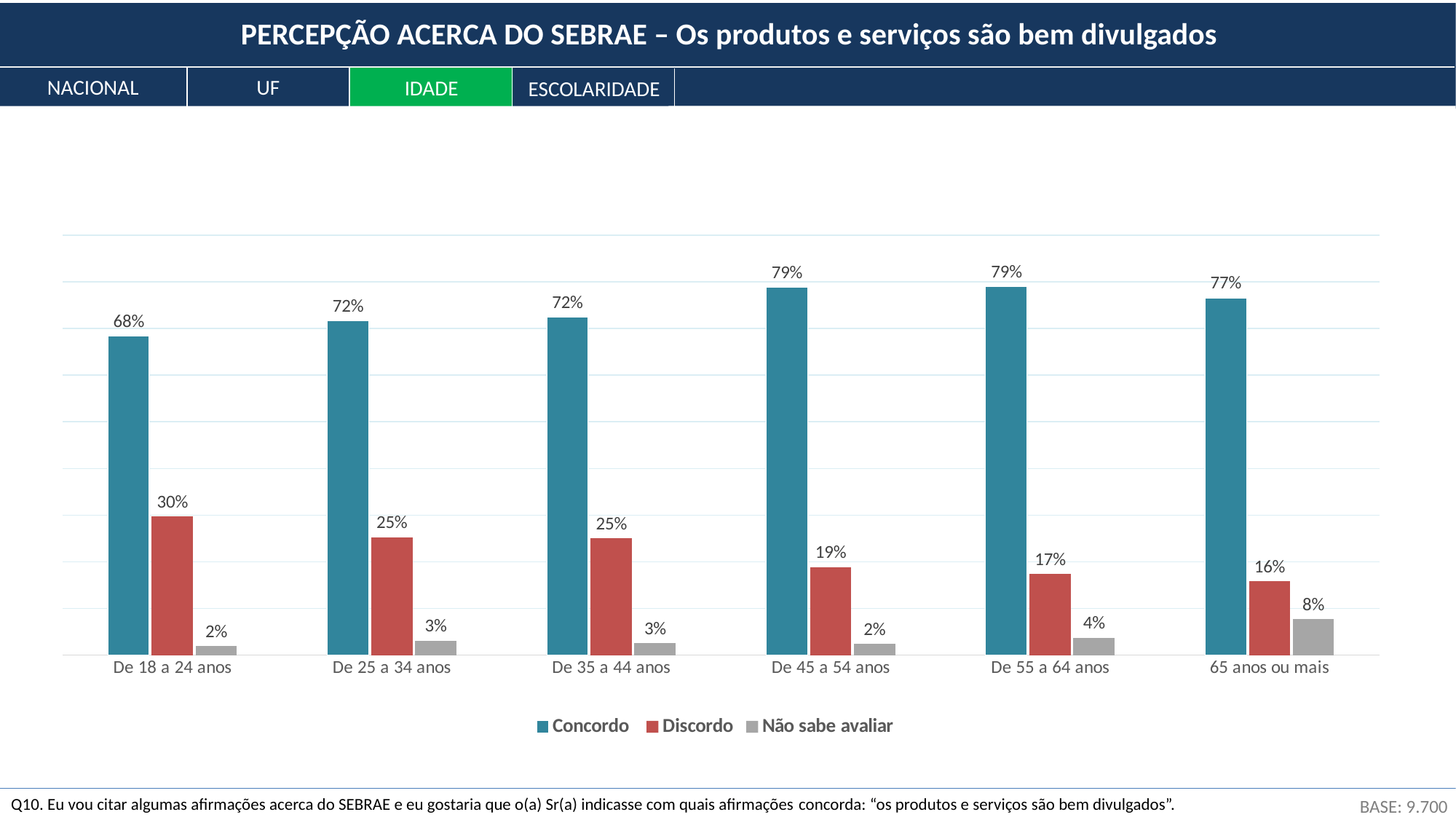
Which tab is highlighted in green above the chart? IDADE What is the difference between the Concordo values for De 45 a 54 anos and De 18 a 24 anos? 11% How many age groups are shown on the x axis? 6 How many series does the legend list? 3 What is the Discordo value for De 45 a 54 anos? 19% Does the Discordo value generally rise or fall from the youngest to the oldest age group? Fall What is the Concordo value for De 18 a 24 anos? 68% What kind of chart is shown on the slide? Bar chart Which age group has the lowest Concordo value? De 18 a 24 anos Which is larger: the Discordo value for De 25 a 34 anos or for De 55 a 64 anos? De 25 a 34 anos Which age group has the highest Discordo value? De 18 a 24 anos What is the Não sabe avaliar value for 65 anos ou mais? 8%